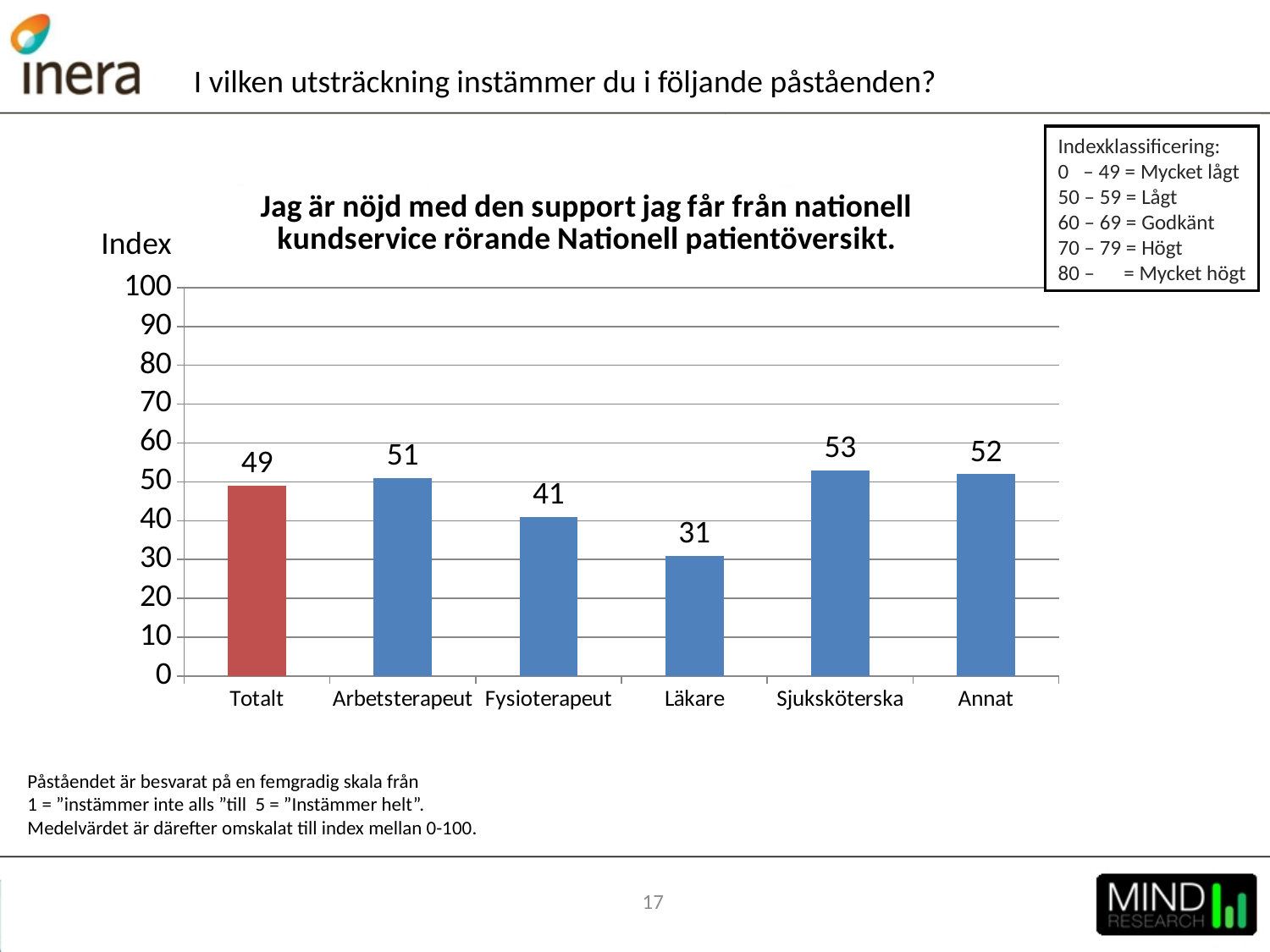
Which category has the highest index value? Sjuksköterska What kind of chart is shown on the slide? bar chart Which category has the lowest index value? Läkare What is the difference between the index values for Sjuksköterska and Läkare? 22 Is the value for Fysioterapeut greater or less than 50? less Which has a higher index value, Arbetsterapeut or Fysioterapeut? Arbetsterapeut What is the index value for Läkare? 31 Which bar is coloured differently (red) from the others? Totalt What is the difference between the index values for Annat and Totalt? 3 How many categories are shown on the x axis? 6 What is the index value for Totalt? 49 What is the index value for Sjuksköterska? 53